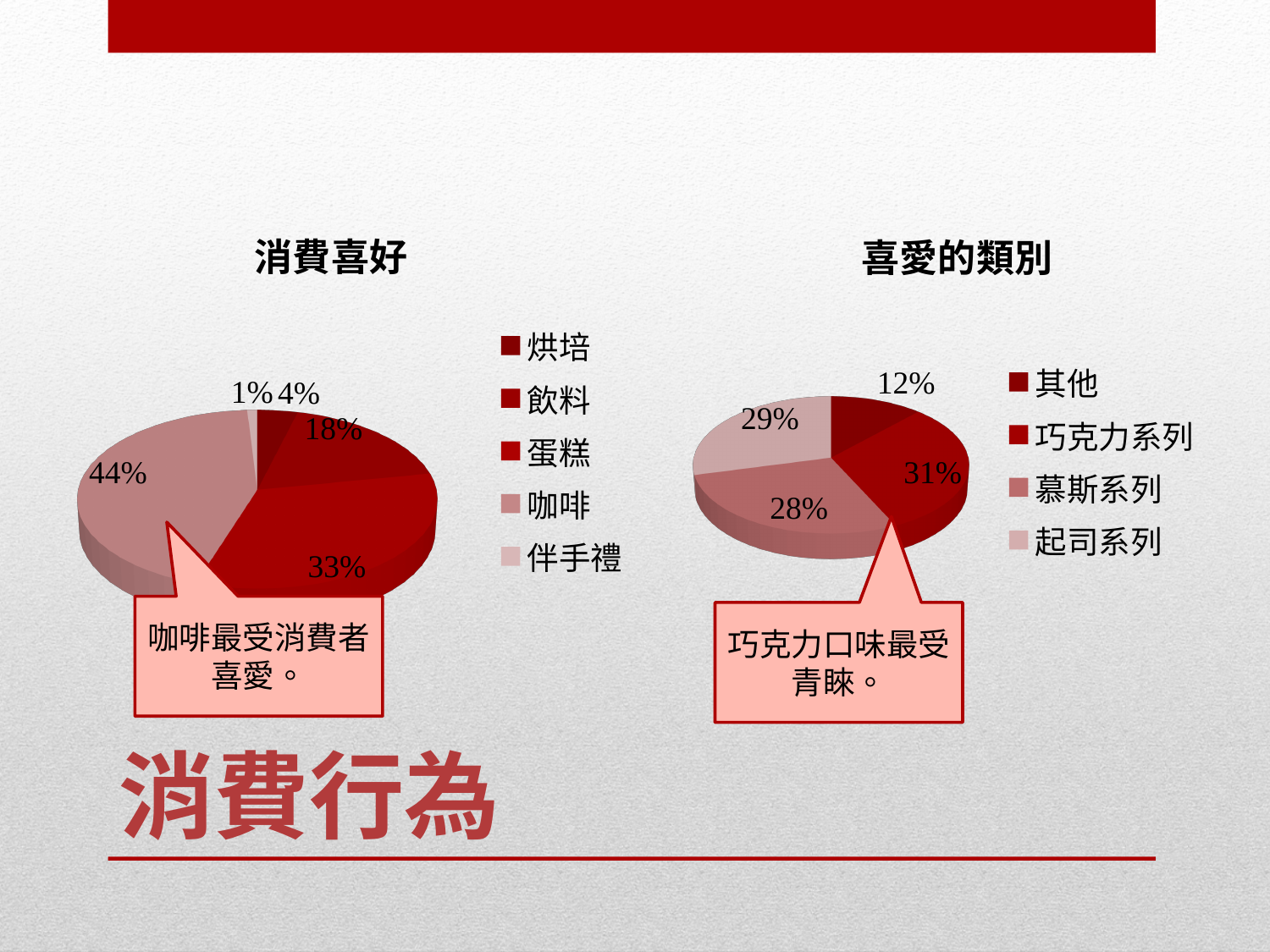
In the 喜愛的類別 chart, what percentage is 慕斯系列? 28% In the 消費喜好 chart, what percentage is 烘培? 4% In the 喜愛的類別 chart, what percentage is 起司系列? 29% In the 喜愛的類別 chart, what is the difference between 巧克力系列 and 其他? 19% In the 喜愛的類別 chart, what percentage is 巧克力系列? 31% In the 喜愛的類別 chart, what percentage is 其他? 12% In the 喜愛的類別 chart, which category has the largest share? 巧克力系列 In the 消費喜好 chart, what percentage is 咖啡? 44% How many categories does the legend of the 消費喜好 chart list? 5 In the 消費喜好 chart, which category has the largest share? 咖啡 In the 喜愛的類別 chart, which category has the smallest share? 其他 What kind of chart is the 喜愛的類別 chart? pie chart